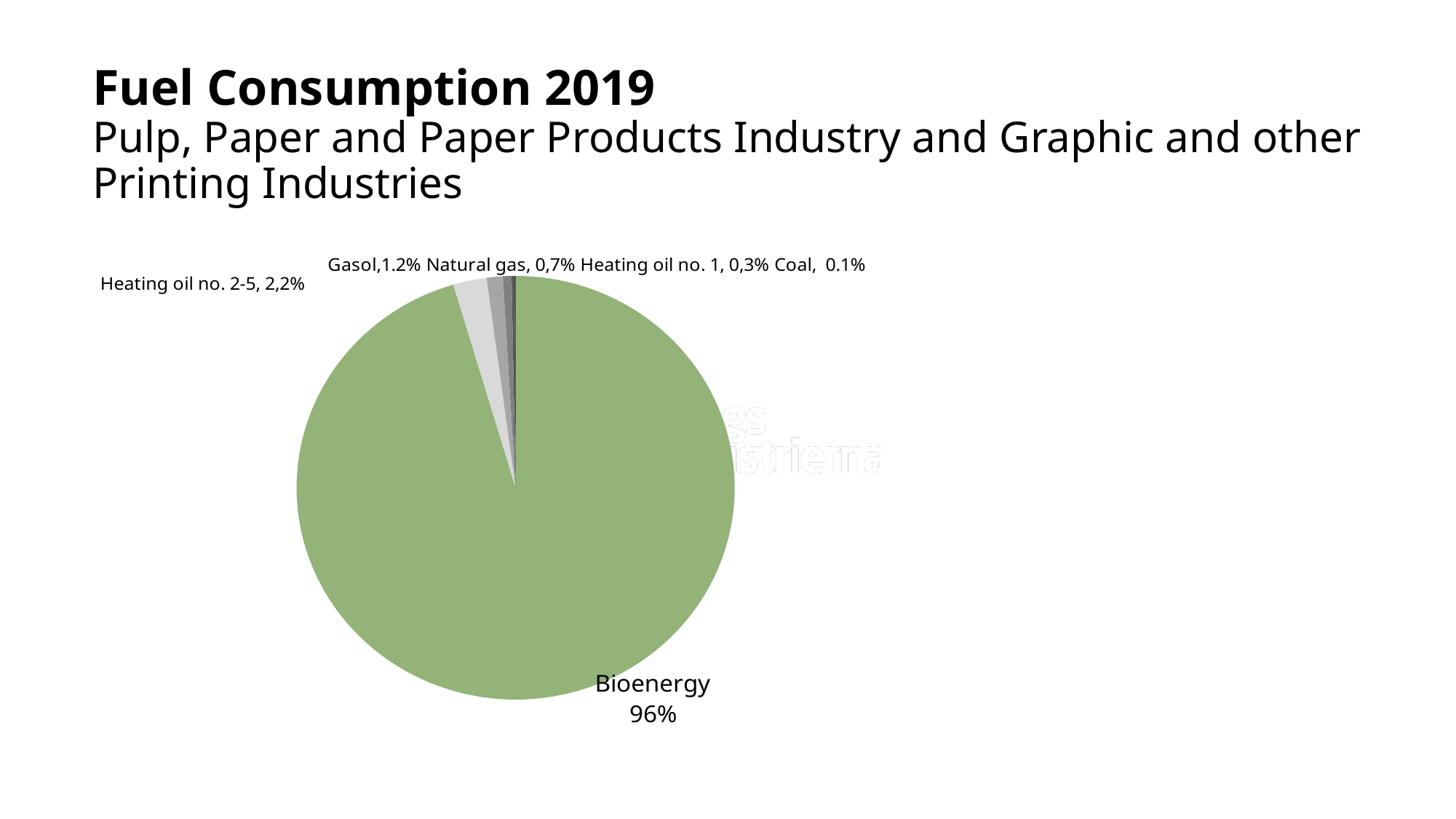
Which fuel has the largest share of the pie? Bioenergy What is the value shown for Heating oil no. 2-5? 2,2% Which is larger, the share for Gasol or the share for Natural gas? Gasol What is the value shown for Natural gas? 0,7% What type of chart is shown on the slide? Pie chart What is the value shown for Gasol? 1.2% What share of fuel consumption does Bioenergy account for? 96% How many slices does the pie chart have? 6 What is the title of the chart on the slide? Fuel Consumption 2019 Which fuel has the smallest share of the pie? Coal What is the value shown for Coal? 0.1% What is the difference between the shares for Heating oil no. 2-5 and Natural gas? 1,5%